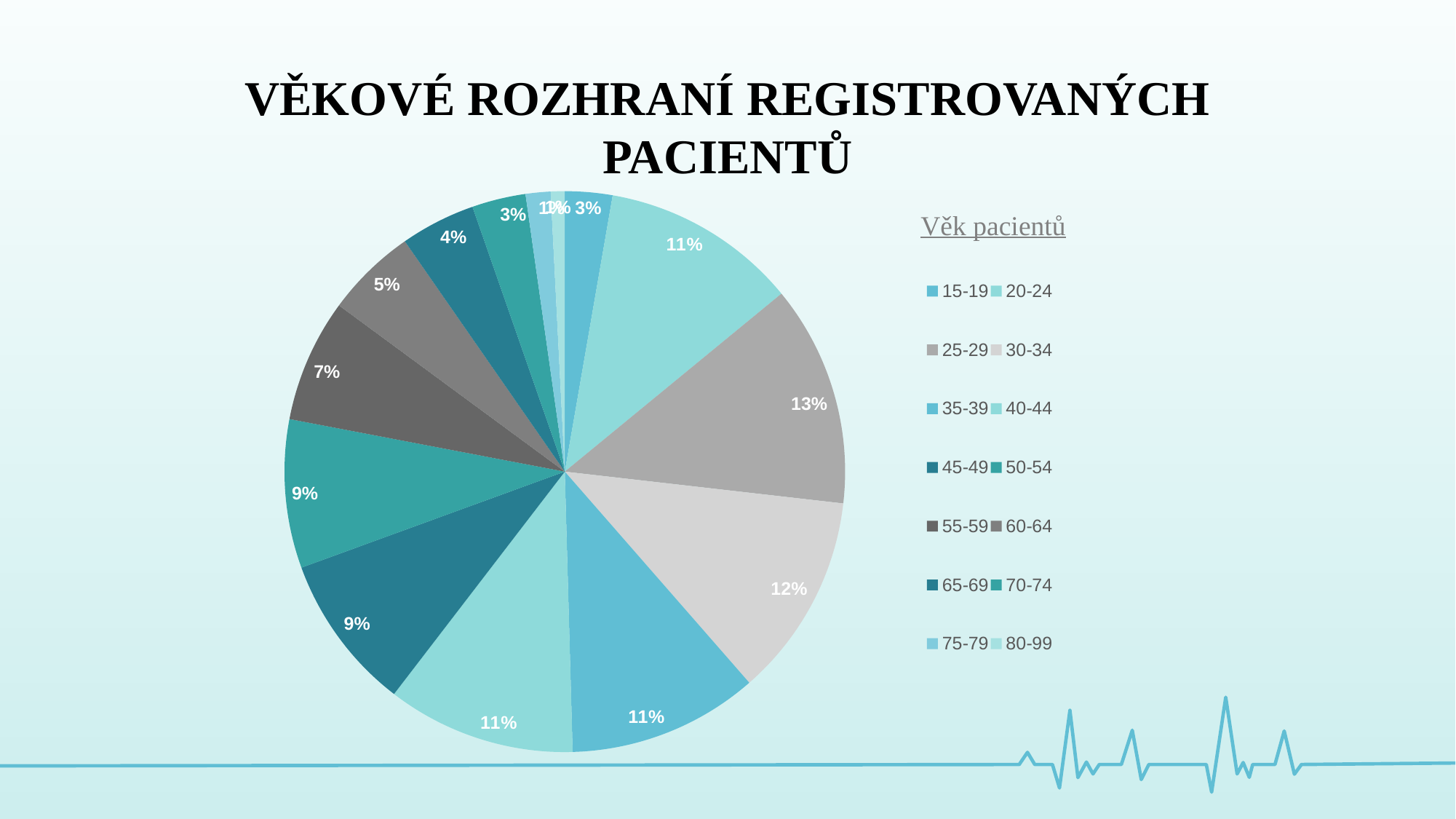
What share of registered patients is in the 30-34 age group? 12% What is the title of the legend? Věk pacientů What percentage is shown for the 65-69 age group? 4% What is the title of the chart on the slide? VĚKOVÉ ROZHRANÍ REGISTROVANÝCH PACIENTŮ What percentage is shown for the 60-64 age group? 5% How many age categories does the legend list? 14 What share of registered patients is in the 25-29 age group? 13% What kind of chart is shown on the slide? pie chart What percentage is shown for the 55-59 age group? 7% Which age group has the largest share of registered patients? 25-29 What is the difference in percentage points between the 25-29 group (13%) and the 60-64 group (5%)? 8 Which is larger, the share for 25-29 or the share for 30-34? 25-29